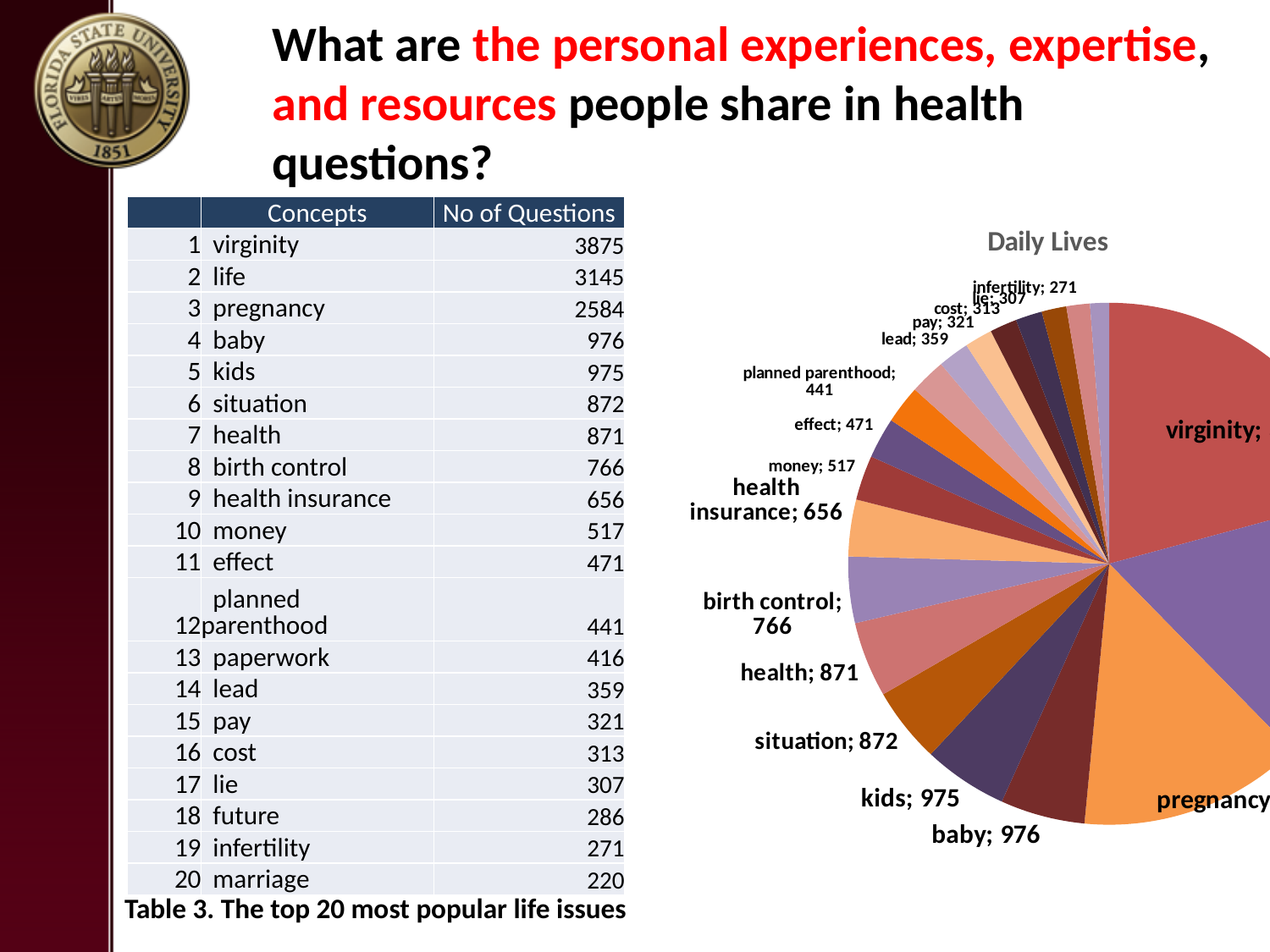
In the Daily Lives pie chart, what is the difference between the values for birth control and health insurance? 110 In the Daily Lives pie chart, what is the value for lead? 359 In the Daily Lives pie chart, what is the difference between the values for money and effect? 46 What type of chart is shown on the slide? pie chart What is the title of the pie chart? Daily Lives In the Daily Lives pie chart, what is the value for situation? 872 In the Daily Lives pie chart, which is larger, pay or infertility? pay In the Daily Lives pie chart, which is larger, health insurance or money? health insurance In the Daily Lives pie chart, what is the value for baby? 976 In the Daily Lives pie chart, what is the value for planned parenthood? 441 In the Daily Lives pie chart, which category has the largest slice? virginity In the Daily Lives pie chart, what is the value for birth control? 766